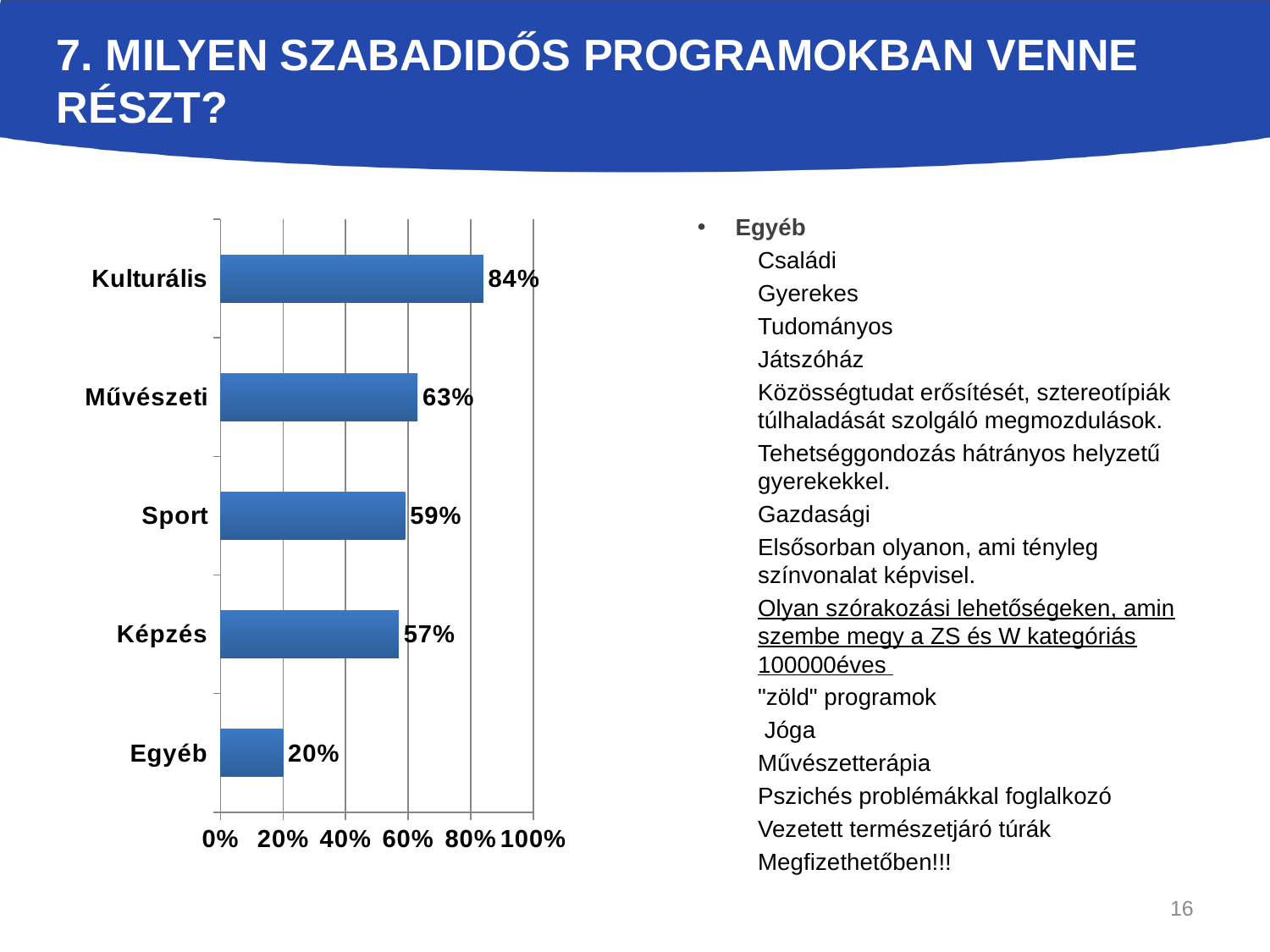
What is the value for Egyéb? 20% Which category has the lowest value? Egyéb Is the value for Képzés greater or less than 40%? greater How many categories are shown in the chart? 5 Which category has the highest value? Kulturális What is the difference between the values for Képzés and Egyéb? 37% What is the difference between the values for Kulturális and Művészeti? 21% What is the maximum value shown on the horizontal axis? 100% Which is larger, the value for Művészeti or the value for Sport? Művészeti What is the value for Kulturális? 84% What kind of chart is shown on the slide? bar chart What is the value for Sport? 59%